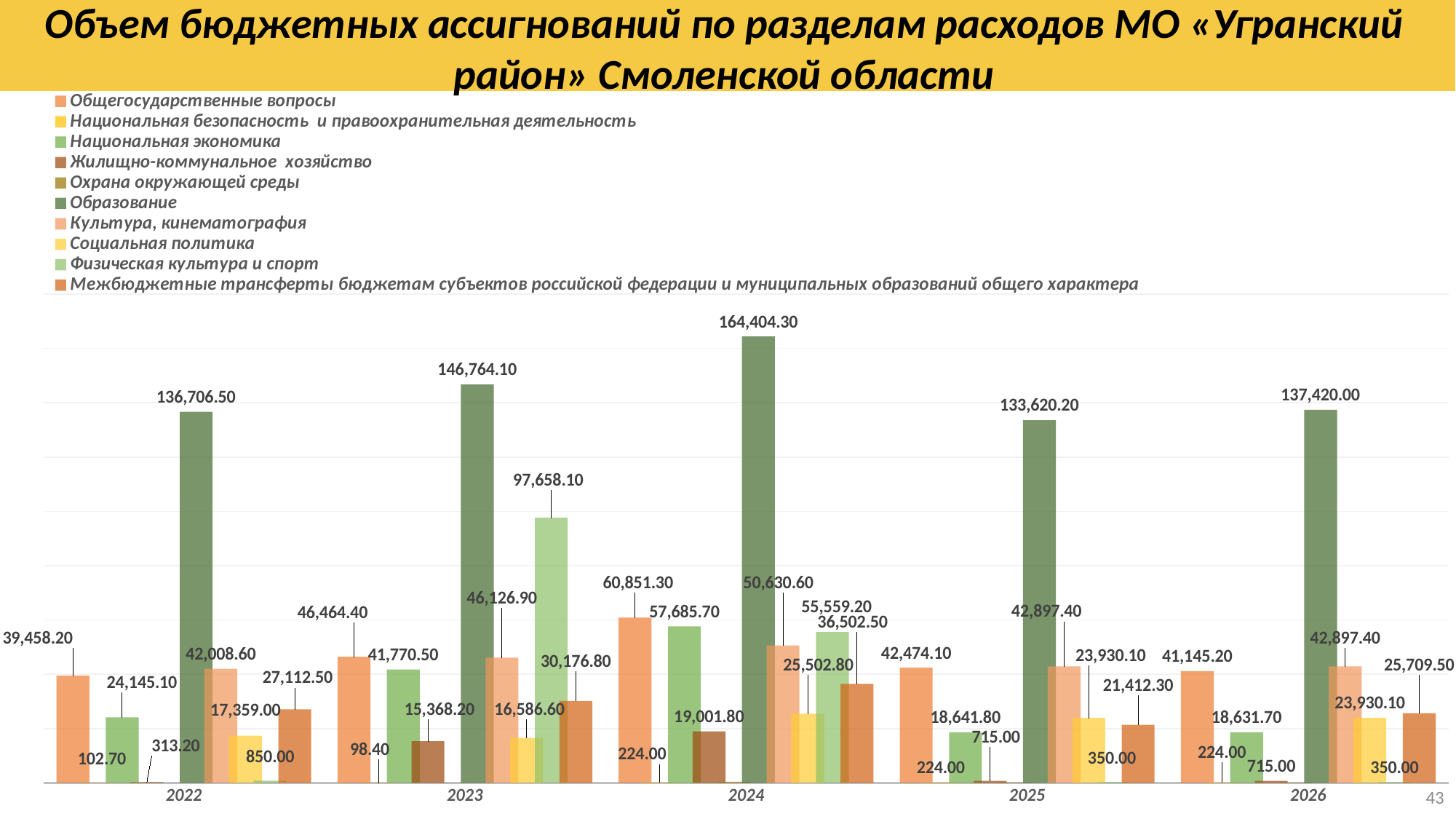
What is the value for Общегосударственные вопросы in 2024? 60,851.30 What is the value for Образование in 2022? 136,706.50 Which is larger: the value for Физическая культура и спорт in 2023 or in 2024? 2023 What is the value for Физическая культура и спорт in 2023? 97,658.10 Which series has the highest value in 2023? Образование What kind of chart is shown on the slide? Bar chart What is the difference between the Образование values for 2024 and 2023? 17,640.20 How many series does the legend list? 10 What is the value for Образование in 2024? 164,404.30 In which year is the value for Образование the highest? 2024 In which year is the value for Образование the lowest? 2025 How many years are shown along the x axis? 5